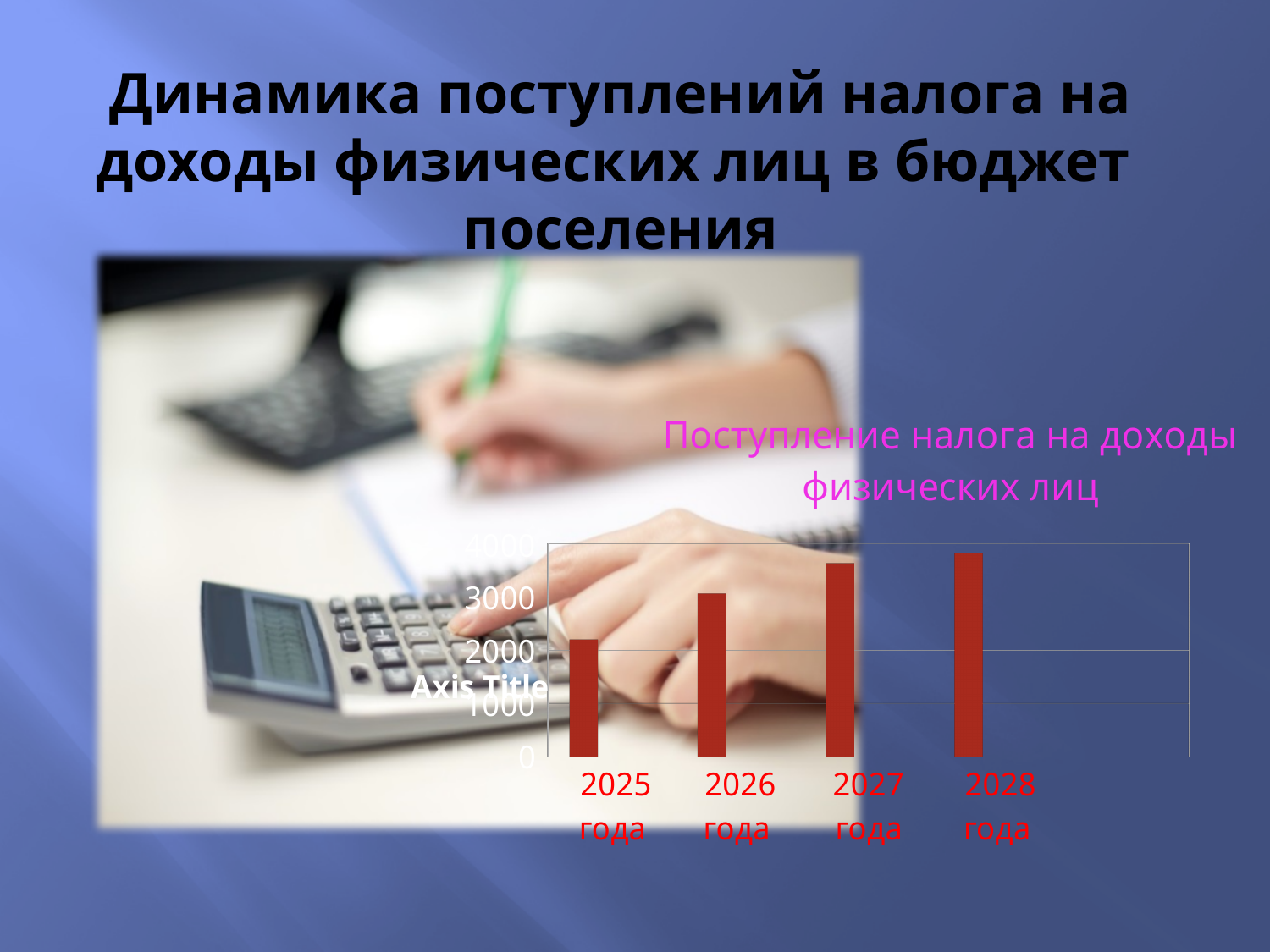
Which year has the highest value on the chart? 2028 года Do the values rise or fall from 2025 to 2028? rise Is the value for 2026 года greater or less than 2000? greater How many years (categories) are shown on the chart? 4 Is the value for 2027 года greater or less than 3000? greater What is the label shown on the vertical axis? Axis Title Is the value for 2025 года greater or less than 3000? less Which year has the lowest value on the chart? 2025 года Which is larger, the value for 2025 года or the value for 2027 года? 2027 года What kind of chart is shown on the slide? bar chart What is the title of the chart? Поступление налога на доходы физических лиц